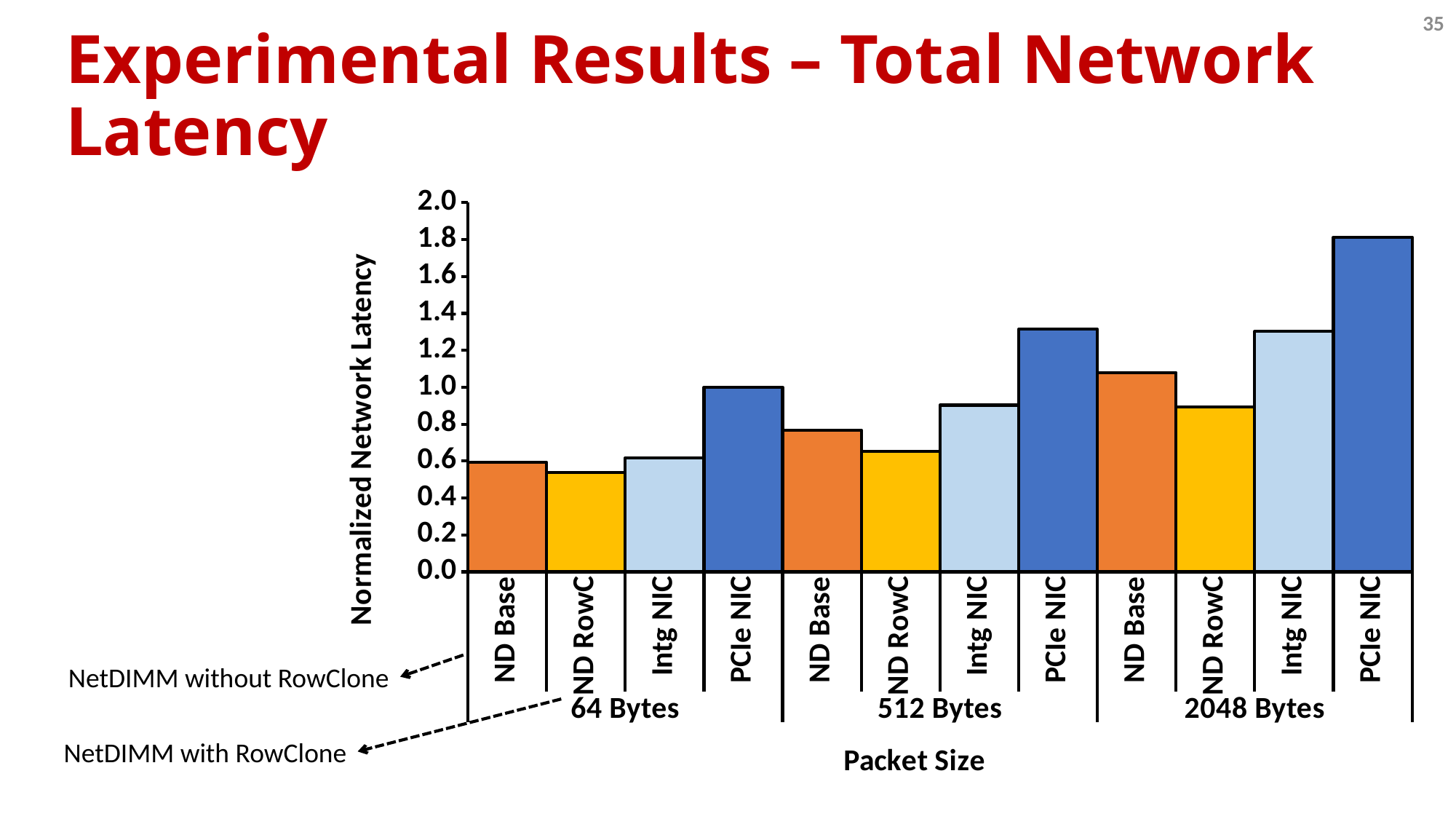
Is the value for ND Base at 2048 Bytes greater or less than 1.0? greater How many bars are plotted in the chart? 12 How many packet size groups are shown on the x axis? 3 Which bar has the highest normalized network latency? PCIe NIC at 2048 Bytes What is the label of the y axis? Normalized Network Latency Is the value for PCIe NIC at 512 Bytes greater or less than 1.2? greater Does the PCIe NIC latency rise or fall as packet size increases from 64 Bytes to 2048 Bytes? rise What kind of chart is shown on the slide? bar chart Which bar has the lowest normalized network latency? ND RowC at 64 Bytes Is the value for PCIe NIC at 2048 Bytes greater or less than 1.6? greater Within the 2048 Bytes group, which is larger: ND Base or ND RowC? ND Base